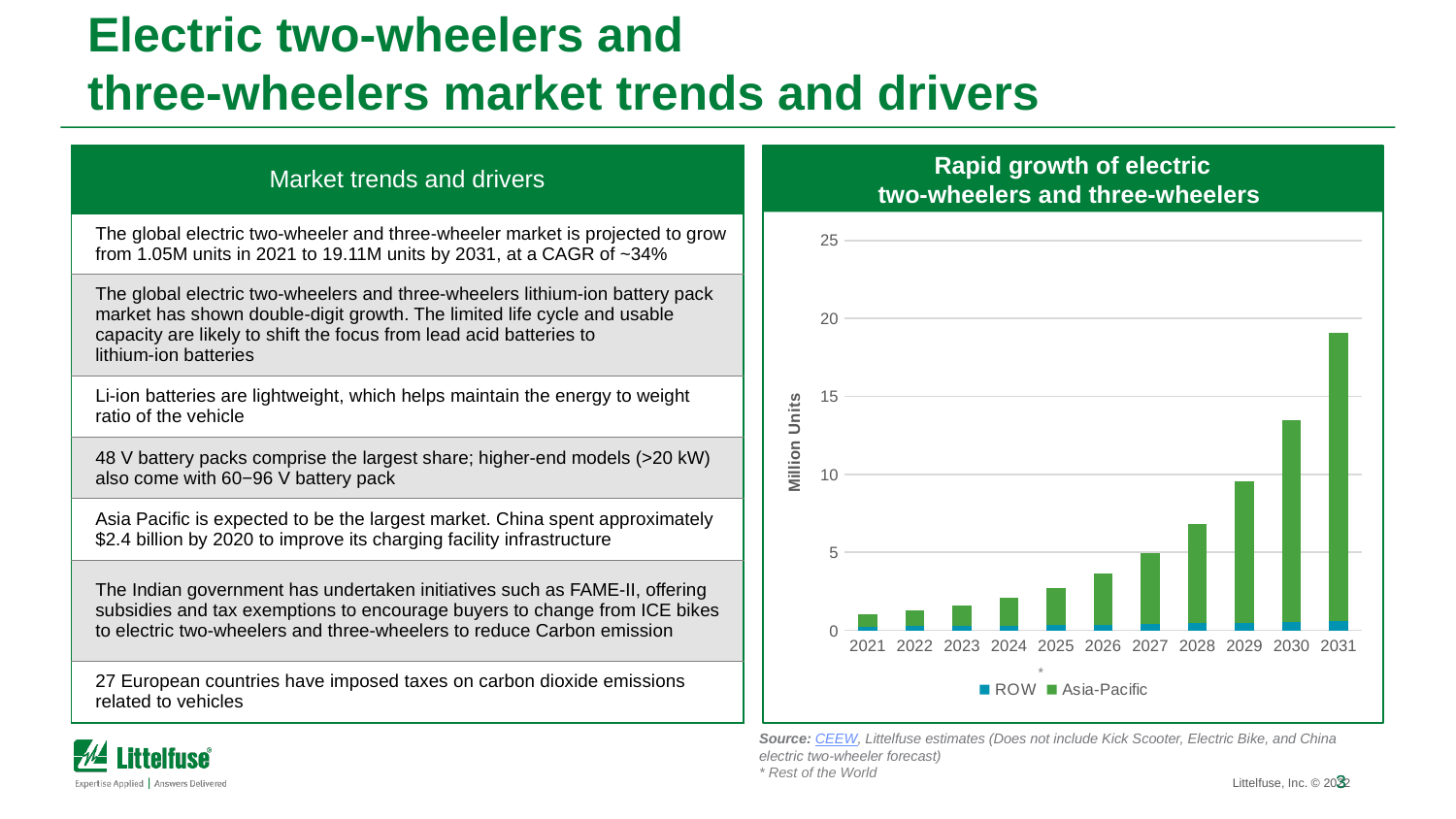
What kind of chart is shown on the slide? Stacked bar chart Which year has the tallest bar in the chart? 2031 Which year has the shortest bar in the chart? 2021 Is the total value for 2026 greater or less than 5 million units? less How many series does the chart's legend list? 2 Is the total value for 2031 greater or less than 15 million units? greater Is the total value for 2030 greater or less than 10 million units? greater What are the two series named in the chart's legend? ROW and Asia-Pacific What is the label on the y axis of the chart? Million Units Which year has the larger total bar, 2028 or 2030? 2030 How many years are shown on the x axis of the chart? 11 Do the bar totals rise or fall from 2021 to 2031? Rise